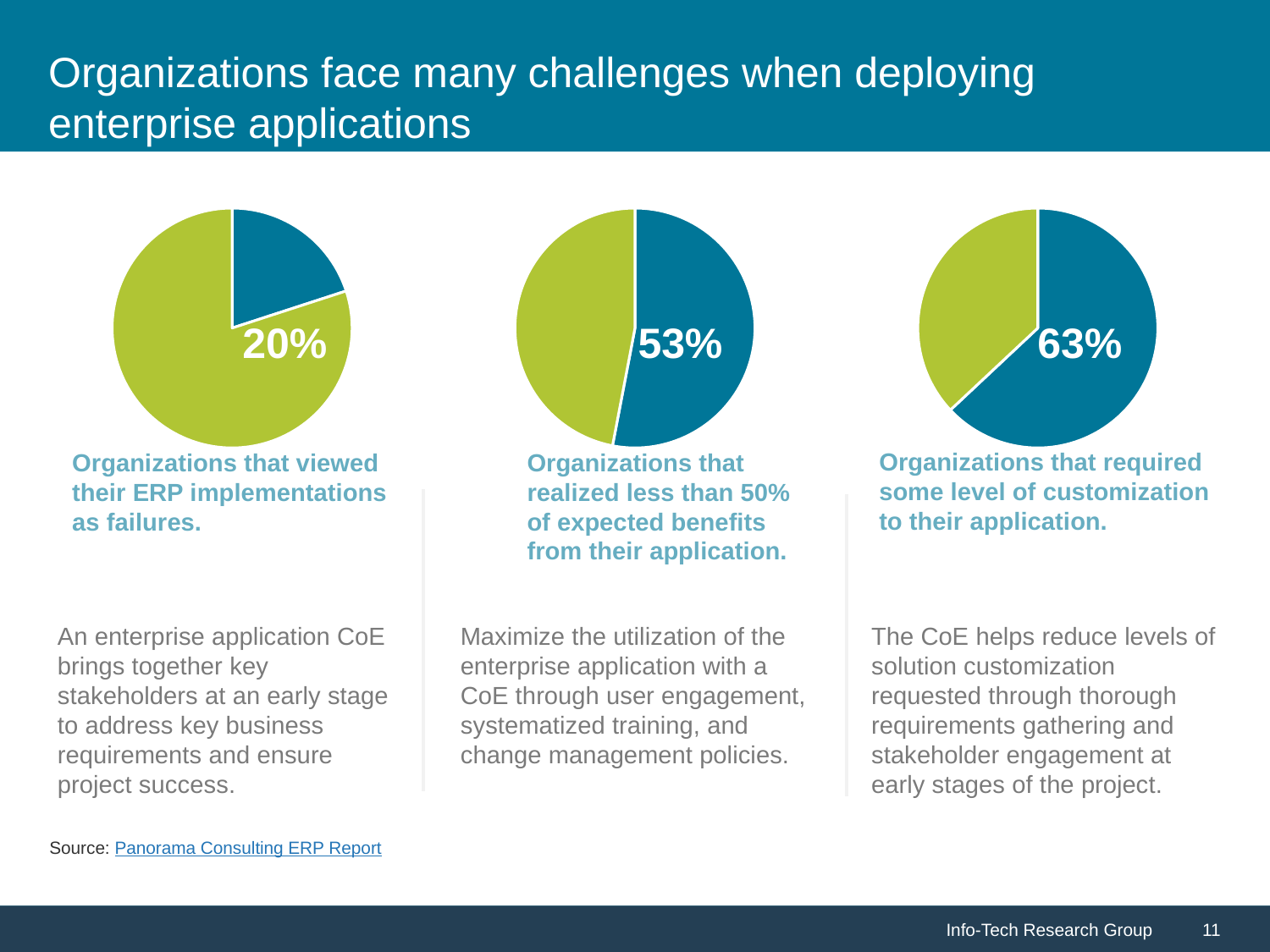
What is the difference between the percentage in the right pie chart (63%) and the percentage in the middle pie chart (53%)? 10% What is the difference between the percentage in the right pie chart (63%) and the percentage in the left pie chart (20%)? 43% Which of the three pie charts shows the largest labeled percentage? The right chart (63%) What colour is the labeled slice in each pie chart? Blue How many pie charts are on the slide? 3 In the right pie chart, what percentage is shown for organizations that required some level of customization to their application? 63% Which is larger: the percentage in the middle pie chart or the percentage in the left pie chart? The middle pie chart (53%) In the left pie chart, what percentage is shown for organizations that viewed their ERP implementations as failures? 20% What kind of charts are shown on the slide? Pie charts In the middle pie chart, what percentage is shown for organizations that realized less than 50% of expected benefits from their application? 53% Which of the three pie charts shows the smallest labeled percentage? The left chart (20%) How many slices does the left pie chart have? 2